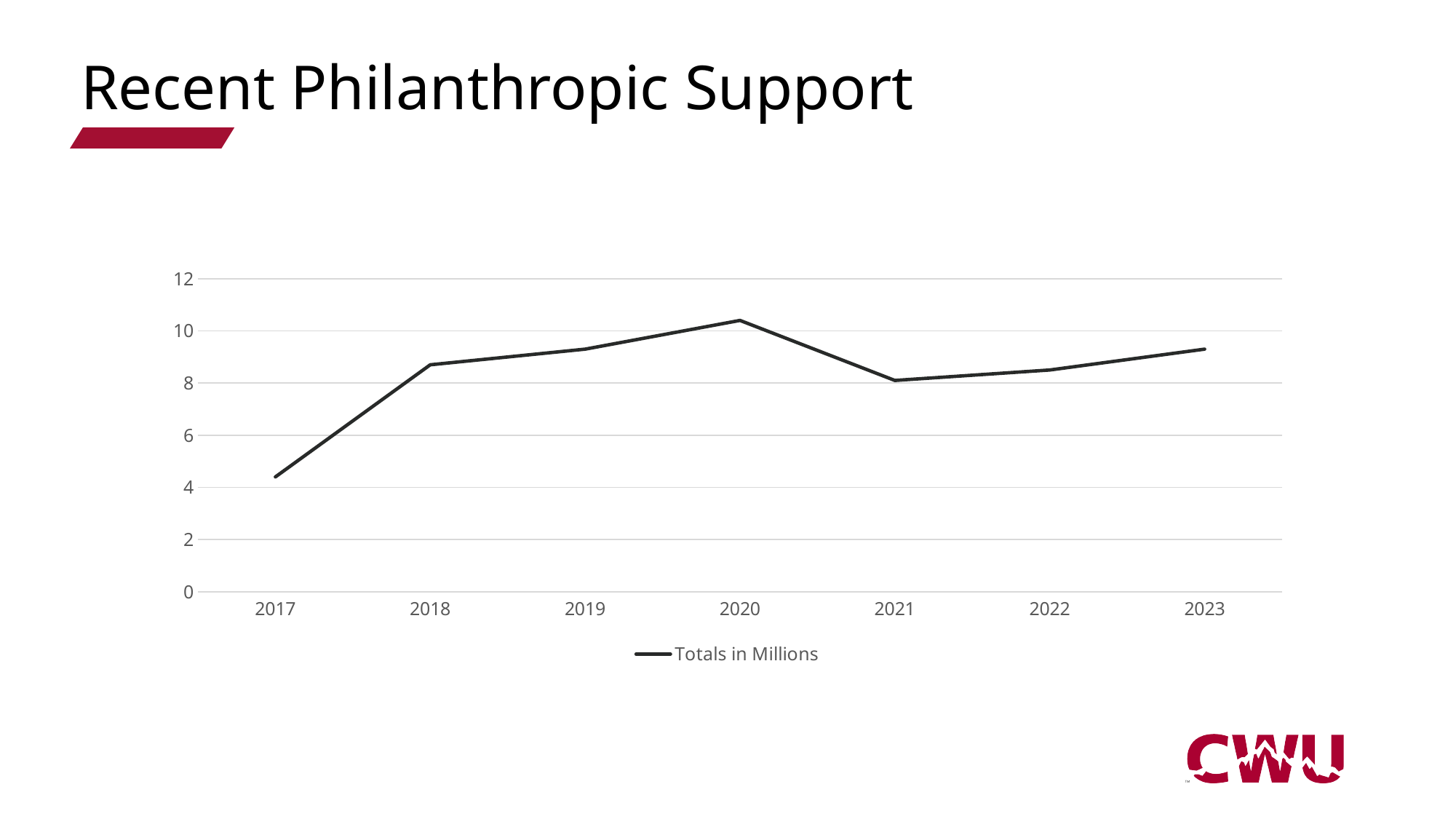
Which year has the larger value, 2020 or 2021? 2020 What kind of chart is shown on the slide? Line chart How many series does the legend list? 1 Is the value for 2020 greater or less than 10? greater Which year has the lowest value for Totals in Millions? 2017 How many years are plotted on the x axis? 7 Does the line rise or fall from 2017 to 2020? Rises Which year has the larger value, 2017 or 2018? 2018 Which year has the highest value for Totals in Millions? 2020 What is the name of the series shown in the legend? Totals in Millions Is the value for 2017 greater or less than 6? less Is the value for 2023 greater or less than 10? less